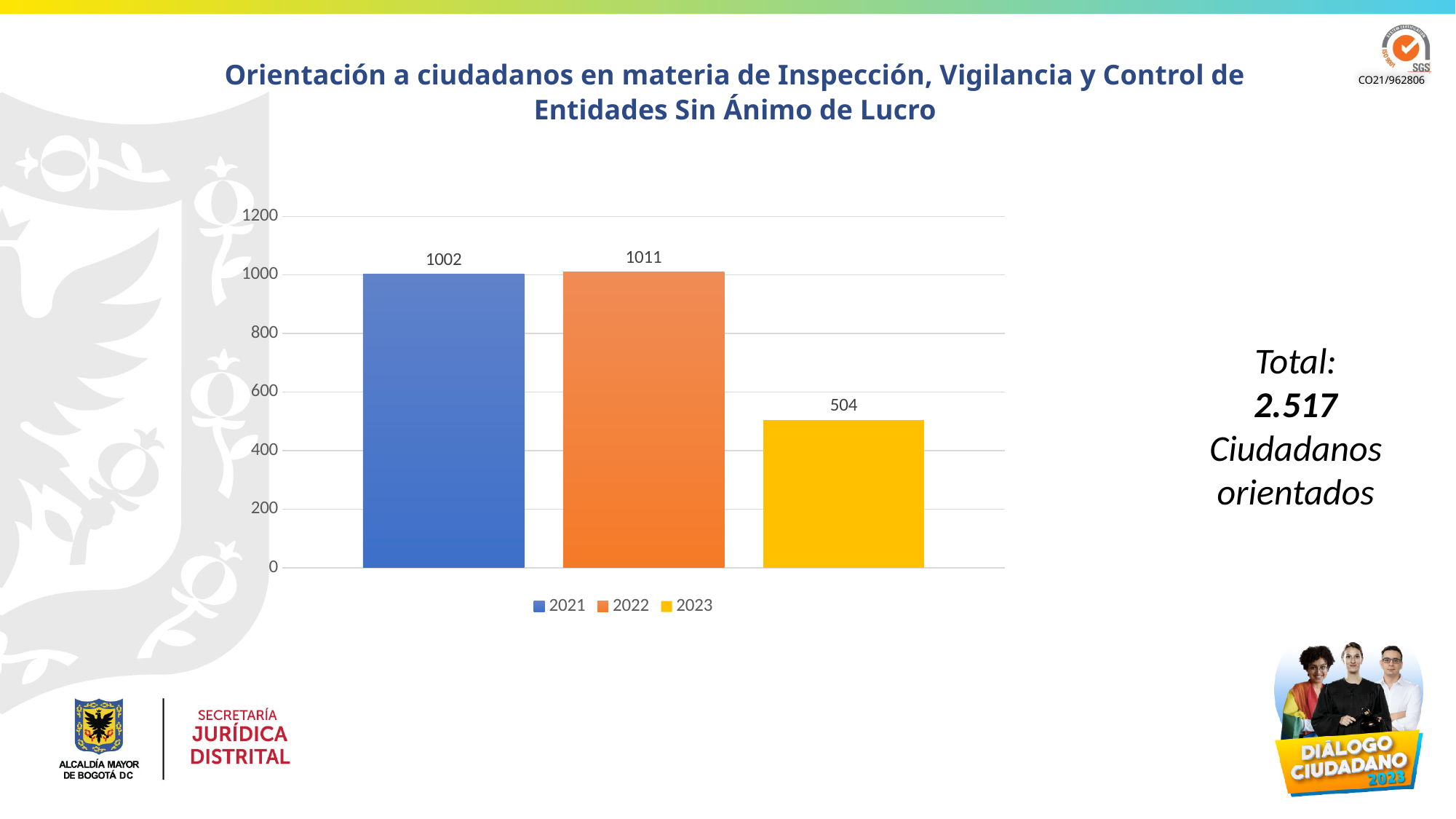
What colour is the bar for 2023? yellow What is the difference between the values for 2022 and 2021? 9 How many series does the legend list? 3 What is the value for 2021? 1002 What is the difference between the values for 2022 and 2023? 507 Which is larger, the value for 2021 or the value for 2023? 2021 What is the value for 2023? 504 What is the value for 2022? 1011 Which year has the highest value? 2022 Is the value for 2023 greater or less than 600? less Which year has the lowest value? 2023 What kind of chart is shown on the slide? bar chart